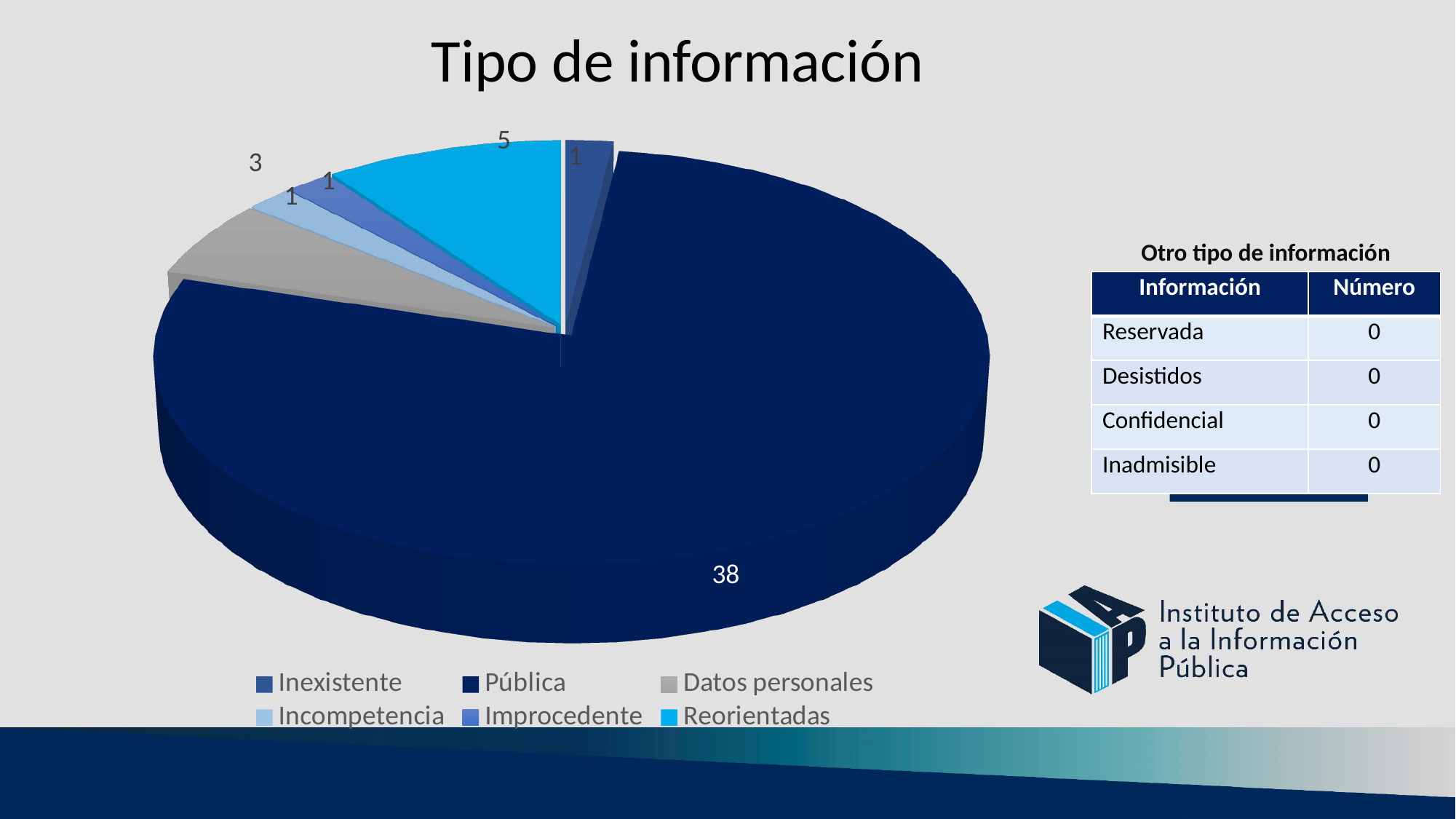
What is the value for Reorientadas in the pie chart? 5 How many categories in the pie chart have a value of 1? 3 Which is larger, the value for Reorientadas or the value for Datos personales? Reorientadas What is the value for Incompetencia in the pie chart? 1 What is the value for Pública in the pie chart? 38 Which category has the largest slice in the pie chart? Pública What is the title of the chart? Tipo de información What is the value for Datos personales in the pie chart? 3 How many categories does the pie chart's legend list? 6 What is the difference between the values for Pública and Reorientadas? 33 What is the difference between the values for Reorientadas and Datos personales? 2 What kind of chart is shown on the slide? pie chart